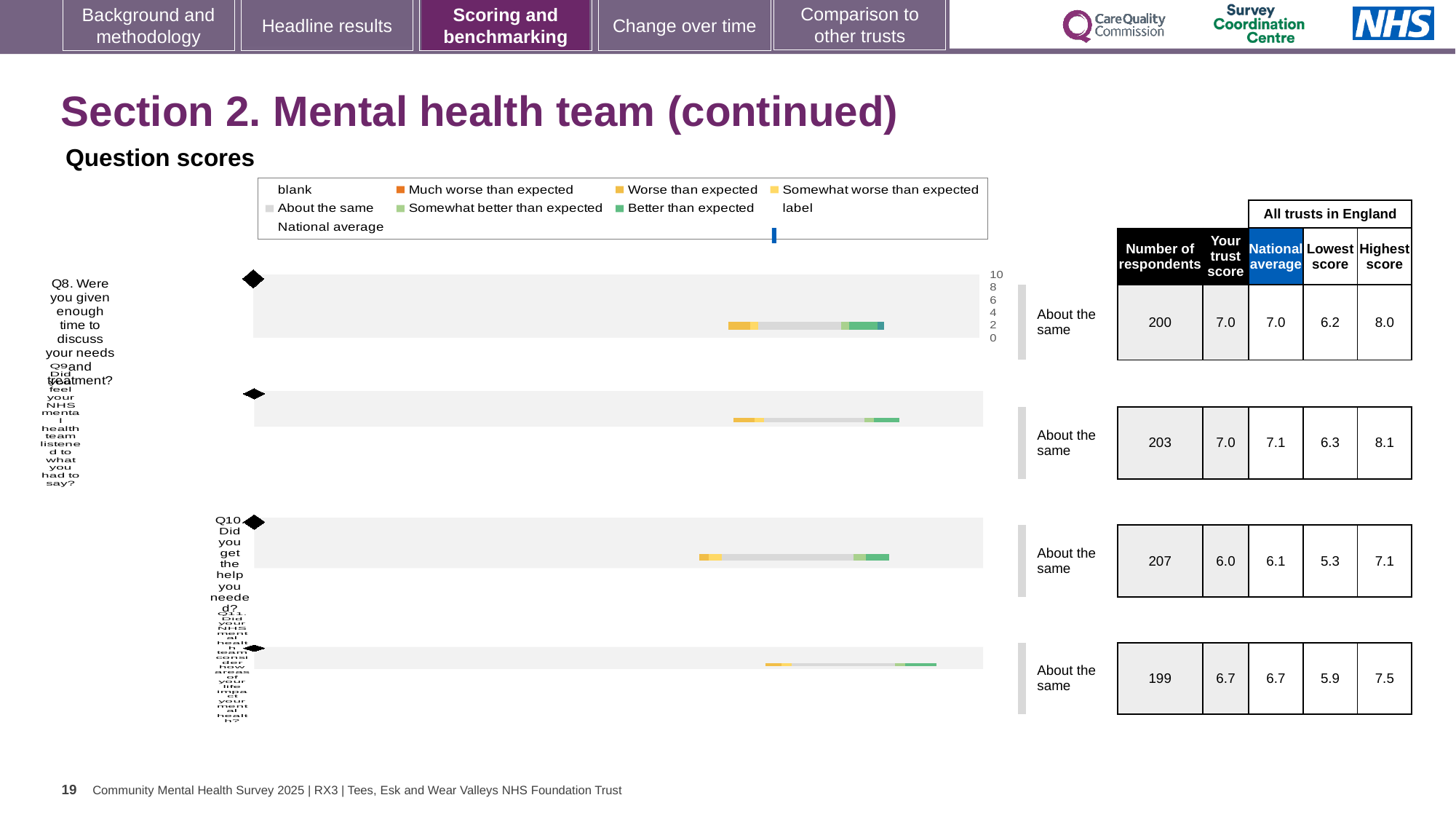
Which question has the lowest 'Your trust score' in the table beside the charts? Q10 In the table beside the charts, what is the highest score for Q11? 7.5 For Q10, what is the difference between the highest score and the lowest score shown in the table? 1.8 In the chart legend, what colour represents 'Much worse than expected'? Orange In the table beside the charts, what is the 'Your trust score' for Q9? 7.0 What kind of chart is used to show the question scores on this slide? Bar chart For Q9, which is larger: the trust score or the national average? National average How many questions (Q8 to Q11) have a benchmark bar chart on this slide? 4 In the table beside the charts, what is the national average for Q10? 6.1 What benchmark label is shown next to the Q8 chart? About the same In the table beside the charts, what is the number of respondents for Q8? 200 In the table beside the charts, what is the lowest score for Q11? 5.9